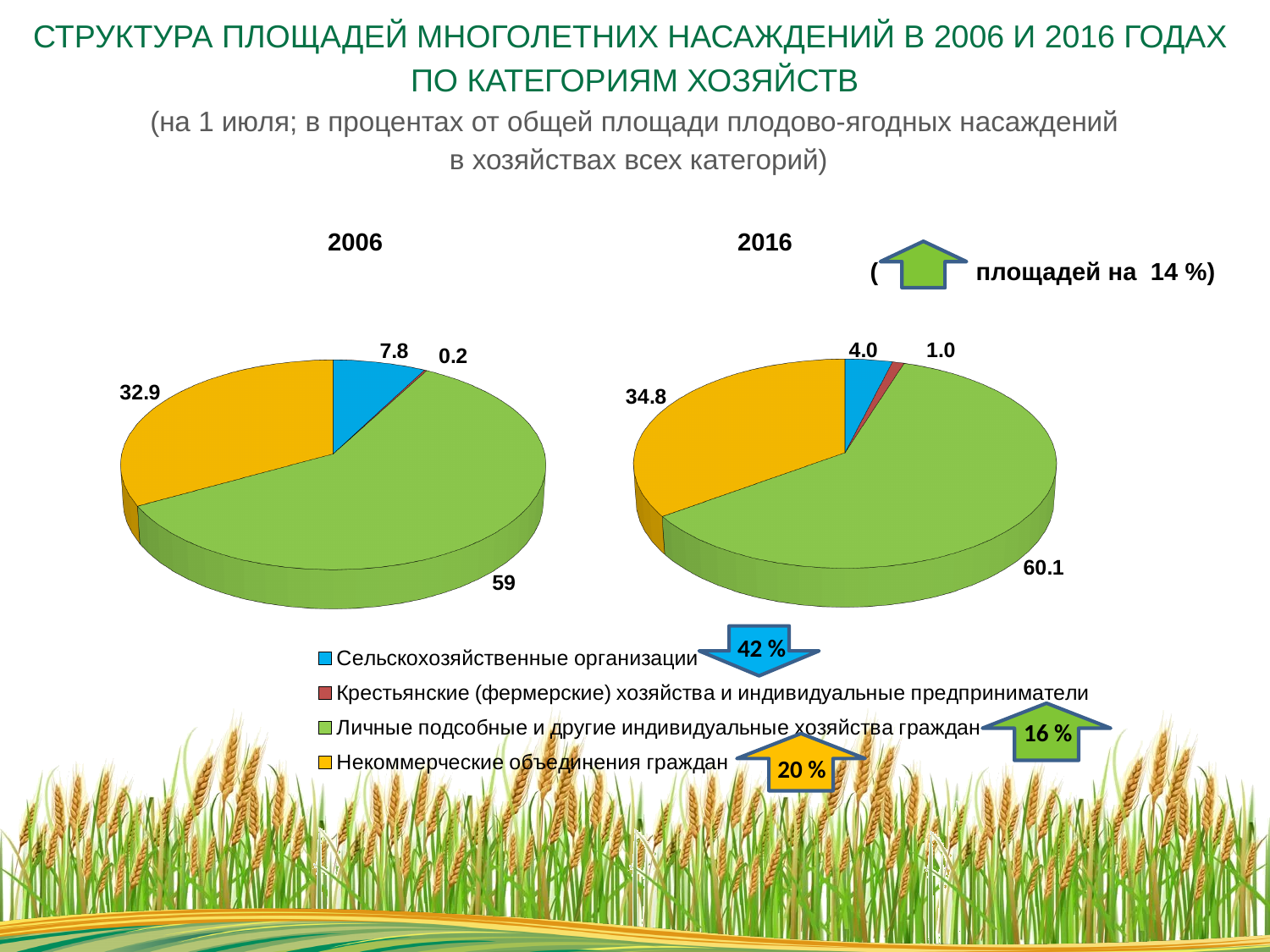
In the 2006 pie chart, what is the value for Личные подсобные и другие индивидуальные хозяйства граждан? 59 In the 2016 pie chart, which category has the largest share? Личные подсобные и другие индивидуальные хозяйства граждан What kind of chart is the 2006 chart? pie chart Which colour represents Некоммерческие объединения граждан in the pie charts? yellow Which is larger: the value for Некоммерческие объединения граждан in the 2006 pie chart or in the 2016 pie chart? 2016 In the 2016 pie chart, what is the value for Некоммерческие объединения граждан? 34.8 How many slices does the 2016 pie chart have? 4 In the 2016 pie chart, what is the value for Крестьянские (фермерские) хозяйства и индивидуальные предприниматели? 1.0 In the 2006 pie chart, what is the value for Сельскохозяйственные организации? 7.8 How many entries does the legend list? 4 In the 2006 pie chart, which category has the smallest share? Крестьянские (фермерские) хозяйства и индивидуальные предприниматели What is the difference between the value for Сельскохозяйственные организации in the 2006 pie chart and in the 2016 pie chart? 3.8